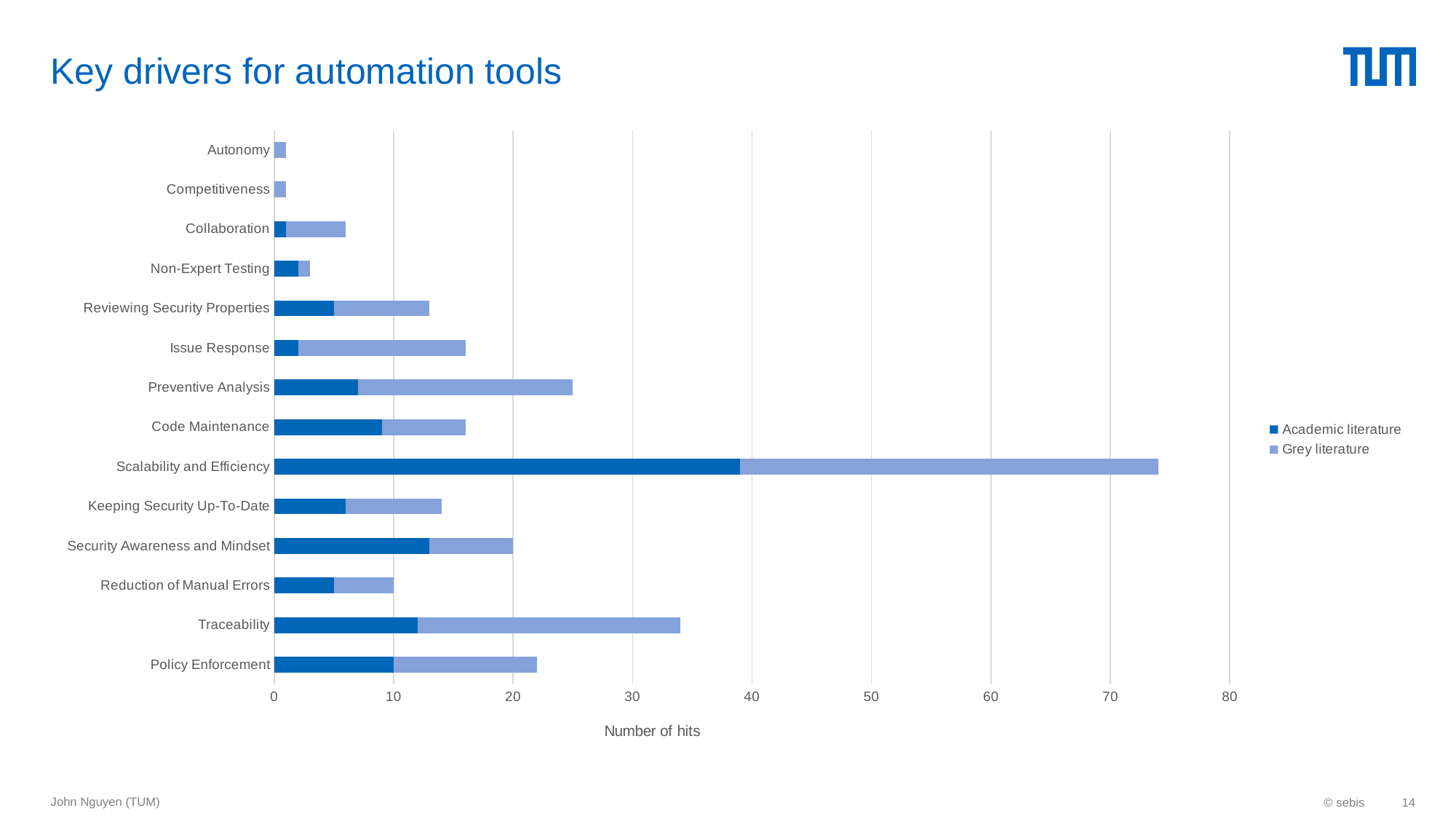
Which has a larger total number of hits, Traceability or Policy Enforcement? Traceability Which key driver has the largest Academic literature segment? Scalability and Efficiency Which has a larger Academic literature segment, Security Awareness and Mindset or Code Maintenance? Security Awareness and Mindset Which key driver has the highest total number of hits? Scalability and Efficiency How many categories (key drivers) are plotted on the chart? 14 Is the total number of hits for Issue Response greater or less than 20? less Is the total number of hits for Scalability and Efficiency greater or less than 70? greater Is the total number of hits for Traceability greater or less than 30? greater How many series does the legend list? 2 What is the label of the horizontal axis? Number of hits What kind of chart is shown on the slide? Stacked bar chart